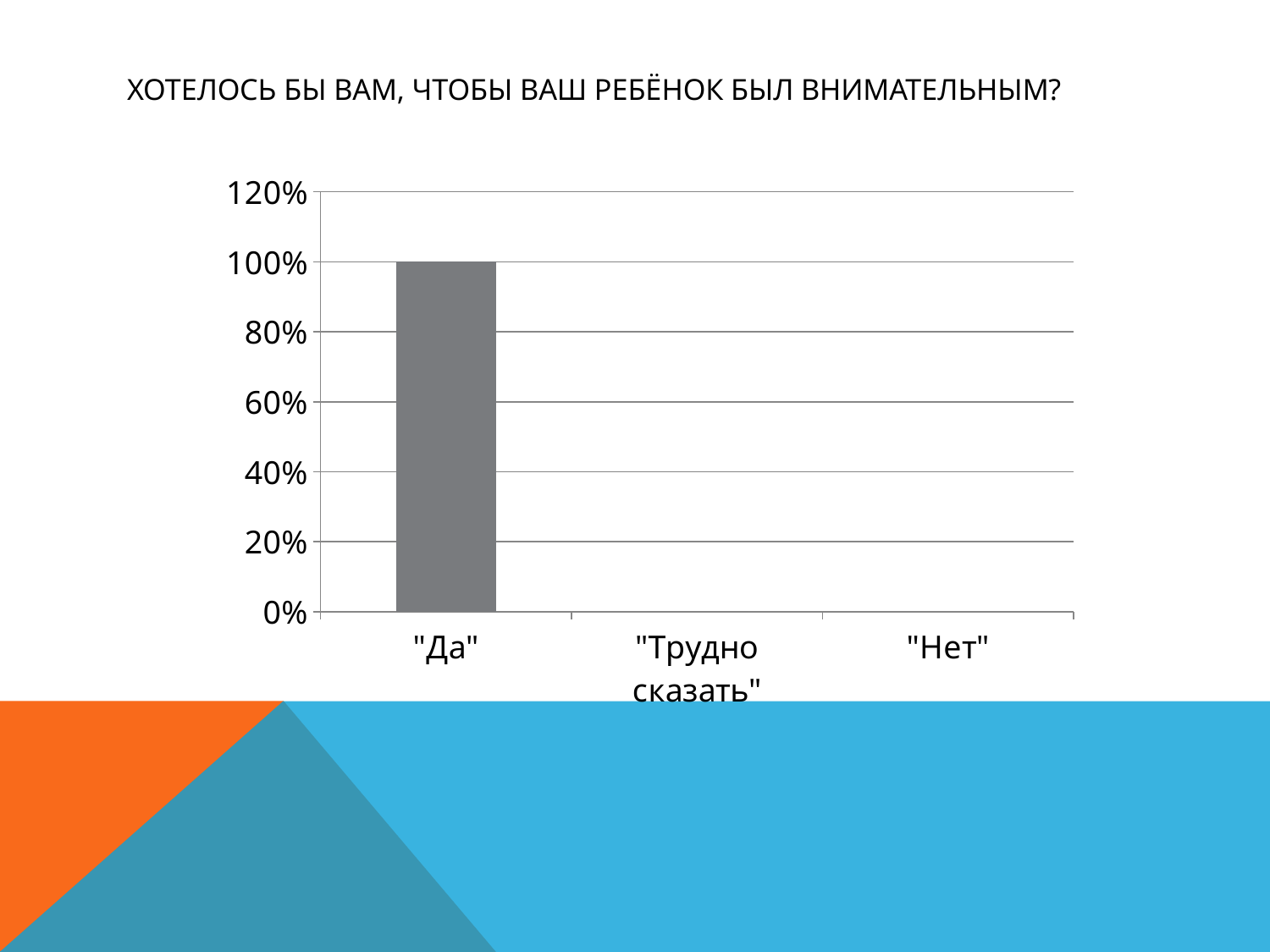
Which is larger, the value for "Да" or the value for "Трудно сказать"? "Да" Is the value for "Нет" greater or less than 20%? less What colour is the bar for "Да"? grey How many categories are shown on the x axis of the chart? 3 What kind of chart is shown on the slide? bar chart Is the value for "Трудно сказать" greater or less than 20%? less Which category has the highest value in the chart? "Да" What is the title of the chart on the slide? Хотелось бы вам, чтобы ваш ребёнок был внимательным? Is the value for "Да" greater or less than 80%? greater What is the value for the category "Да"? 100% Which is larger, the value for "Да" or the value for "Нет"? "Да"